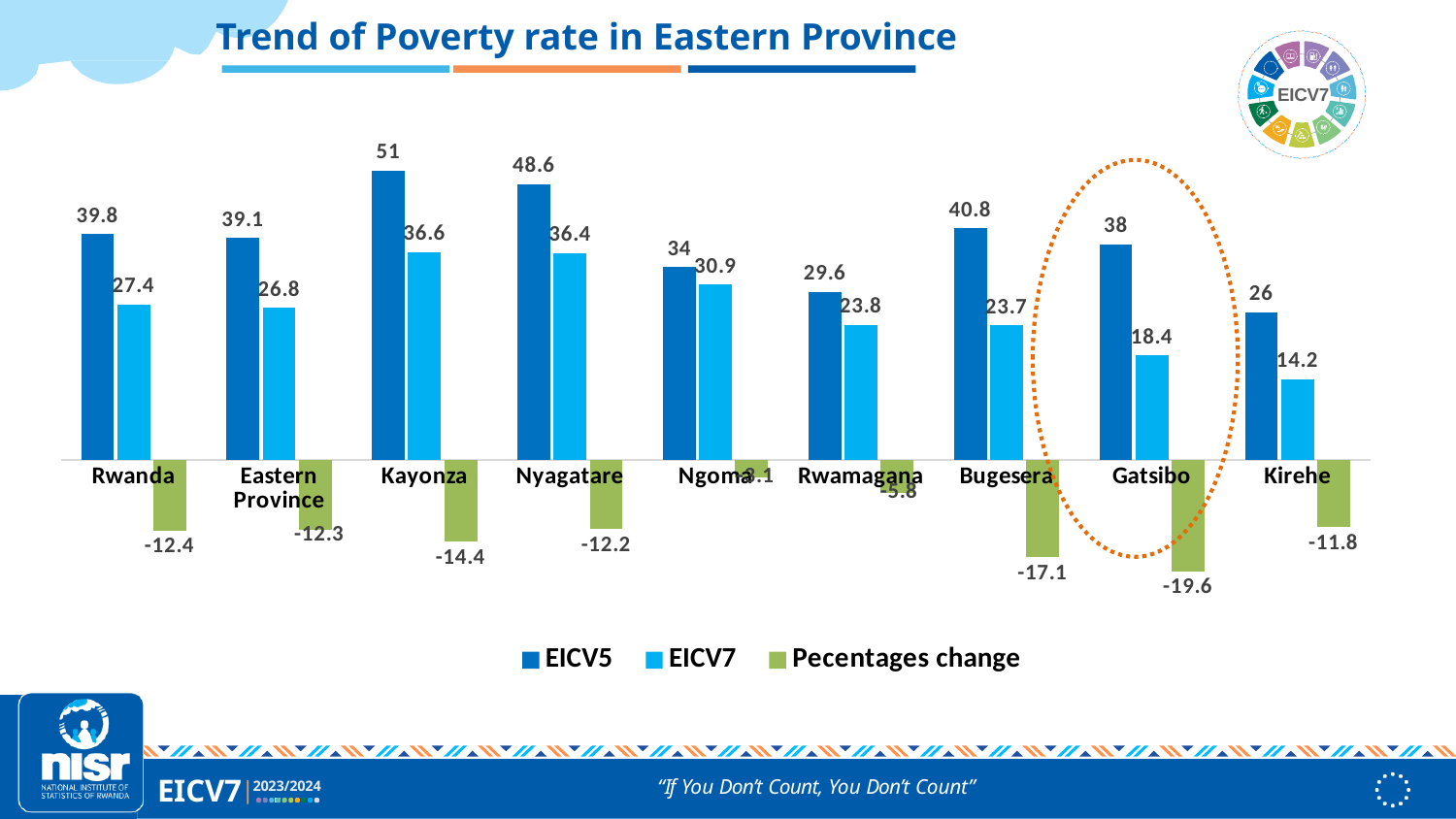
What is the difference between the EICV5 and EICV7 poverty rates for Rwanda? 12.4 Which category has the most negative percentage change? Gatsibo Which category has the lowest EICV7 poverty rate? Kirehe Which has the higher EICV5 poverty rate, Bugesera or Gatsibo? Bugesera Which category is highlighted with a dotted orange circle? Gatsibo Which category has the highest EICV5 poverty rate? Kayonza What kind of chart is shown on the slide? Bar chart What is the EICV5 poverty rate for Kayonza? 51 How many series does the legend list? 3 How many categories are shown on the x axis? 9 What is the percentage change shown for Kirehe? -11.8 What is the EICV7 poverty rate for Gatsibo? 18.4